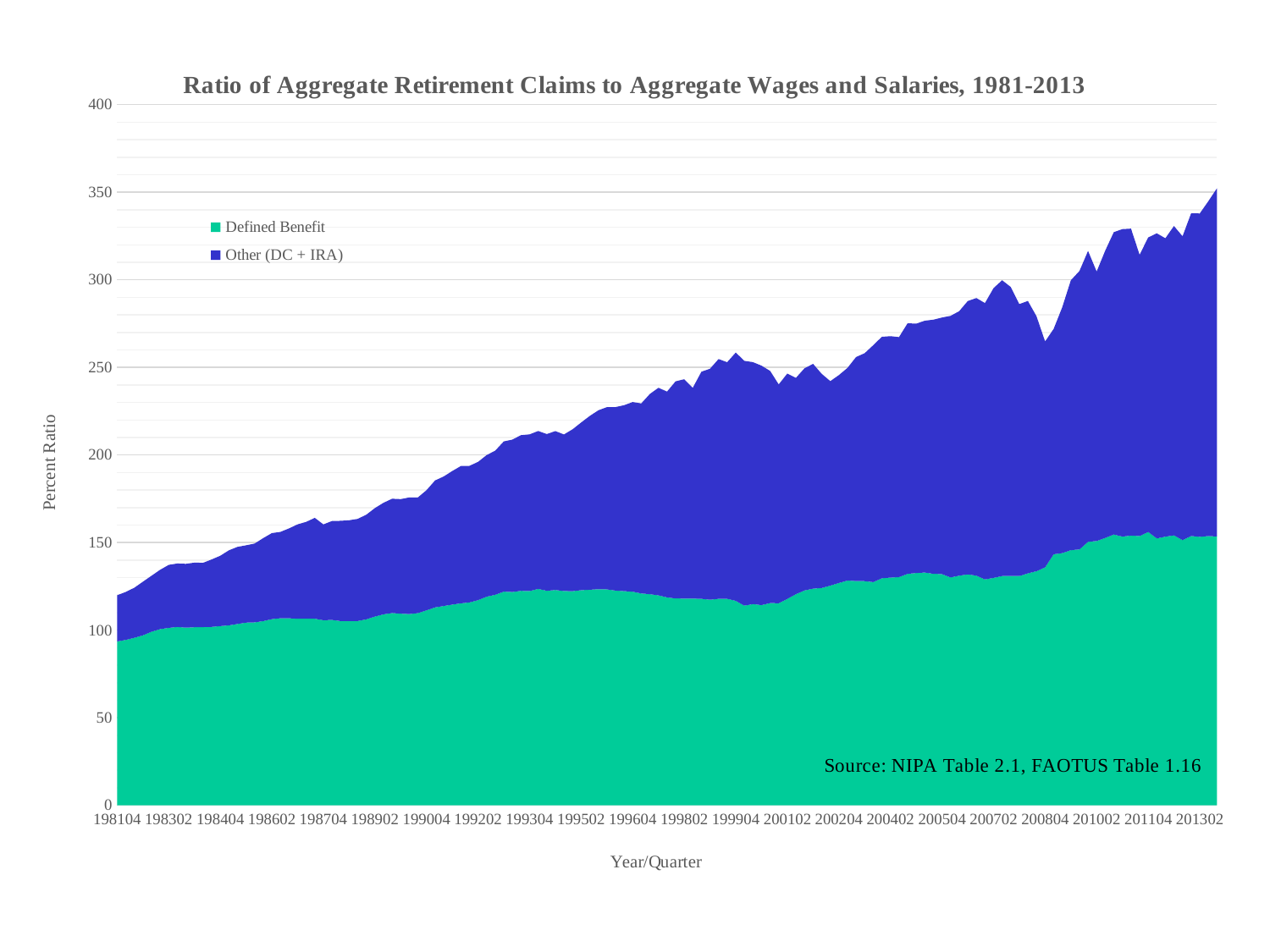
Is the total (Defined Benefit plus Other) at 201302 greater or less than 300? greater Which is larger at 201302, the Defined Benefit portion or the Other (DC + IRA) portion? Other (DC + IRA) Is the total (Defined Benefit plus Other) at 199004 greater or less than 200? less What is the title of the chart? Ratio of Aggregate Retirement Claims to Aggregate Wages and Salaries, 1981-2013 Which series is shown in green? Defined Benefit Is the Defined Benefit value at 199904 greater or less than 150? less How many series does the legend list? 2 What kind of chart is shown on the slide? Stacked area chart Does the total ratio generally rise or fall from 198104 to 201302? Rise